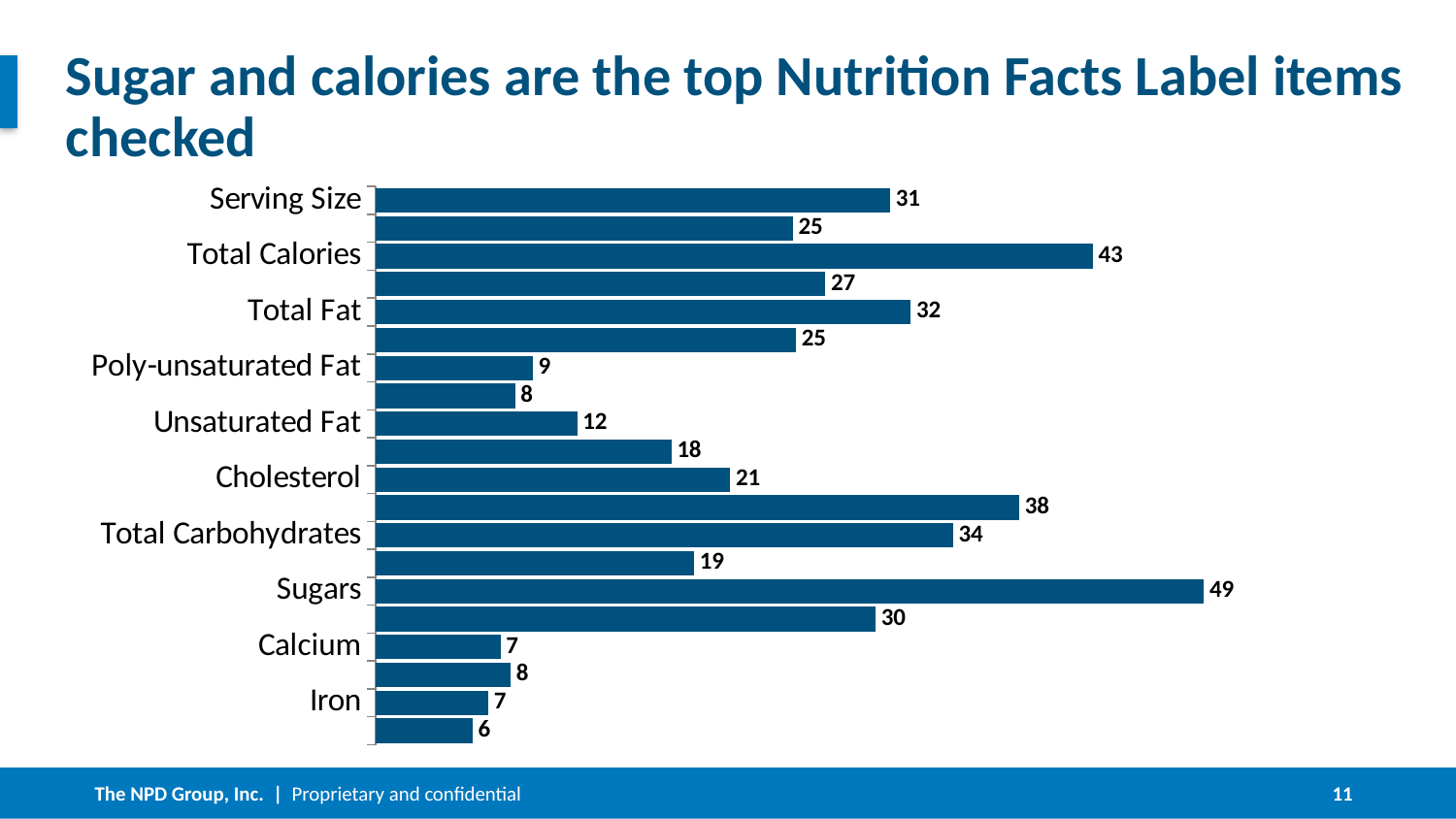
Which is larger, the value for Total Calories or the value for Total Carbohydrates? Total Calories Which category has the highest value? Sugars What is the title of the slide? Sugar and calories are the top Nutrition Facts Label items checked What is the value for Total Calories? 43 What kind of chart is shown on the slide? Bar chart What is the difference between the values for Sugars and Total Calories? 6 What is the value for Sugars? 49 What is the value for Serving Size? 31 What is the difference between the values for Total Carbohydrates and Cholesterol? 13 What is the value for Poly-unsaturated Fat? 9 What is the value for Cholesterol? 21 What is the value for Iron? 7